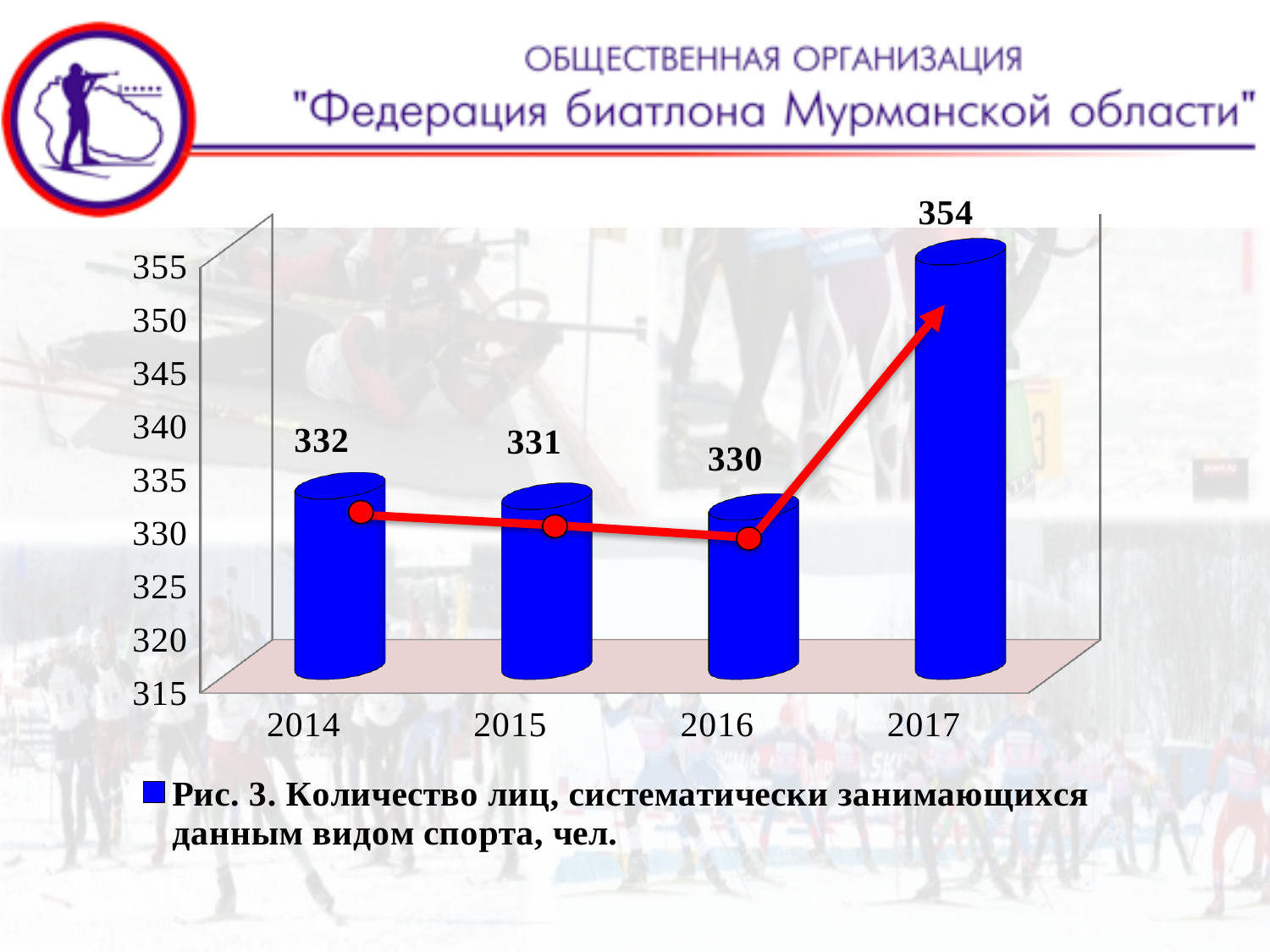
What is the value for 2017? 354 What is the difference between the values for 2014 and 2015? 1 What is the legend entry for the blue series? Рис. 3. Количество лиц, систематически занимающихся данным видом спорта, чел. Which year has the highest value? 2017 Which is larger, the value for 2014 or the value for 2017? 2017 How many years are shown on the x axis? 4 What is the difference between the values for 2017 and 2016? 24 Is the value for 2017 greater or less than 350? greater What is the value for 2014? 332 Which year has the lowest value? 2016 What is the value for 2016? 330 What kind of chart is this? bar chart